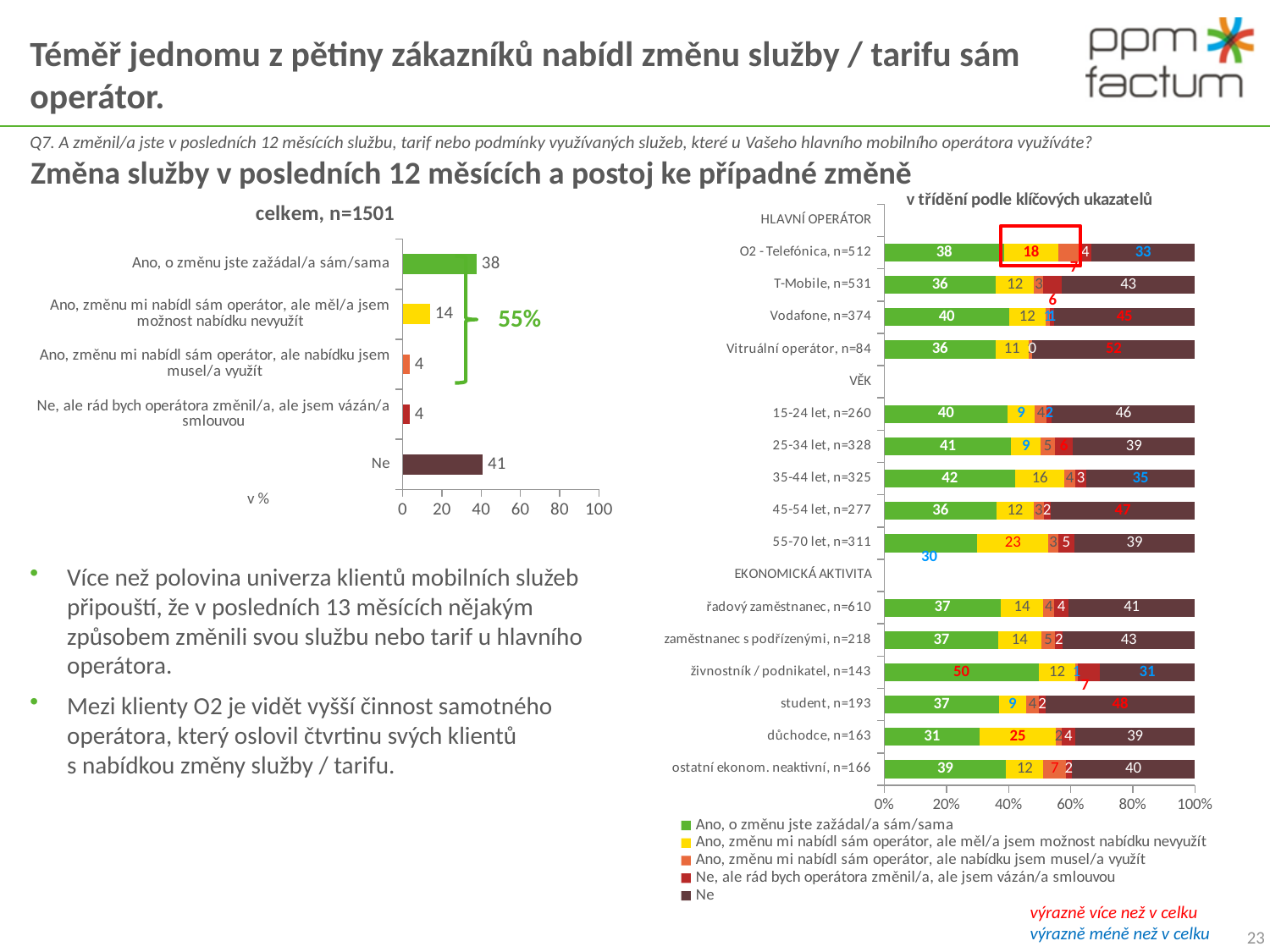
In the chart titled "celkem, n=1501", what is the value for "Ano, o změnu jste zažádal/a sám/sama"? 38 In the chart titled "v třídění podle klíčových ukazatelů", how many series does the legend list? 5 In the chart titled "v třídění podle klíčových ukazatelů", which of "O2 - Telefónica, n=512" and "T-Mobile, n=531" has the larger value for "Ano, změnu mi nabídl sám operátor, ale měl/a jsem možnost nabídku nevyužít"? O2 - Telefónica, n=512 In the chart titled "celkem, n=1501", which category has the highest value? Ne In the chart titled "v třídění podle klíčových ukazatelů", what is the value of "Ano, změnu mi nabídl sám operátor, ale měl/a jsem možnost nabídku nevyužít" for "důchodce, n=163"? 25 In the chart titled "v třídění podle klíčových ukazatelů", what is the value of "Ne" for "Vitruální operátor, n=84"? 52 In the chart titled "celkem, n=1501", what is the value for "Ne"? 41 In the chart titled "celkem, n=1501", what is the difference between the value for "Ne" and the value for "Ano, o změnu jste zažádal/a sám/sama"? 3 In the chart titled "celkem, n=1501", what percentage is shown by the bracket grouping the first three categories? 55% In the chart titled "celkem, n=1501", how many categories are plotted? 5 In the chart titled "v třídění podle klíčových ukazatelů", what is the value of "Ano, o změnu jste zažádal/a sám/sama" for "živnostník / podnikatel, n=143"? 50 What kind of chart is the chart titled "celkem, n=1501"? bar chart